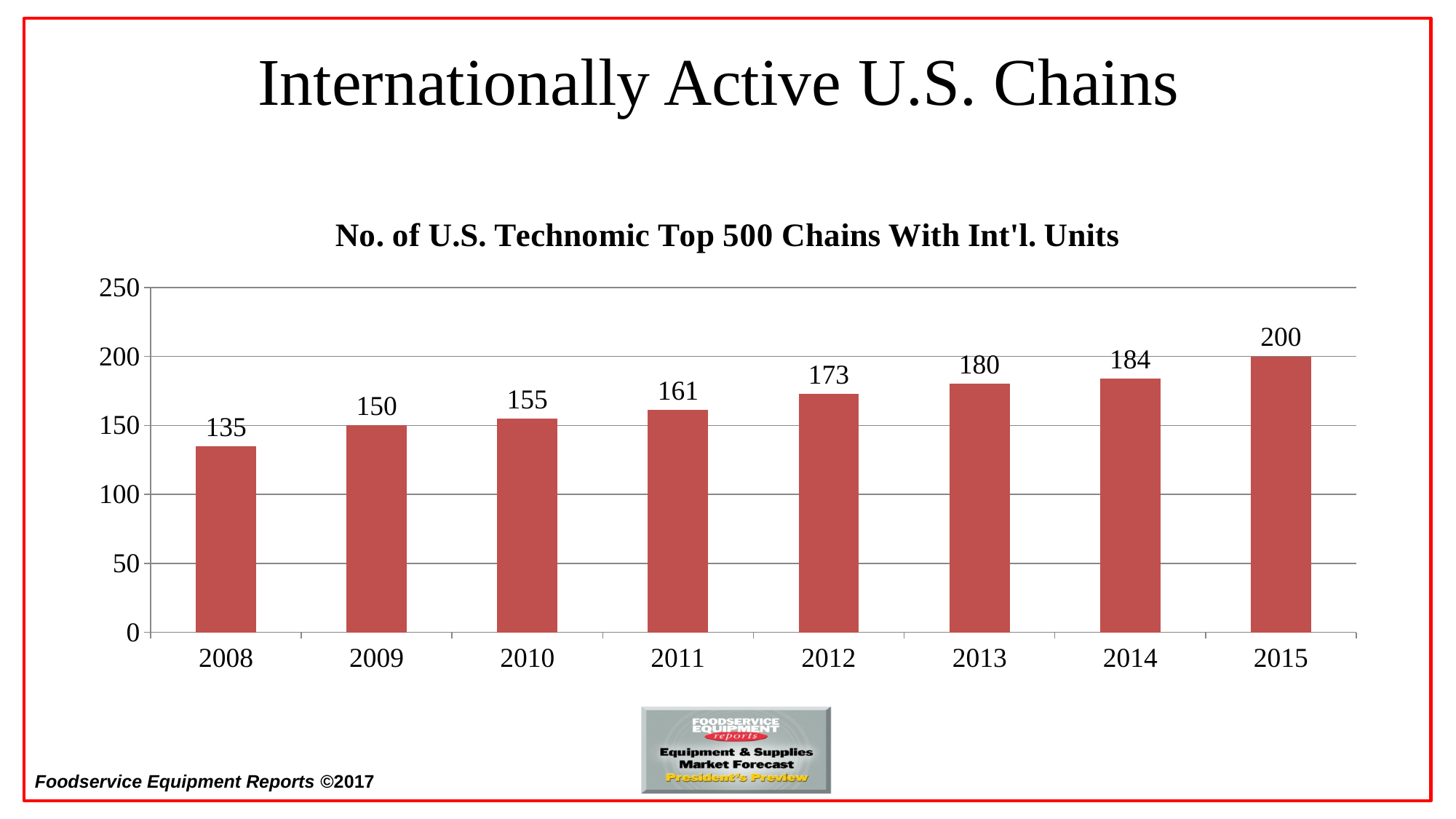
What is the difference between the values for 2015 and 2008? 65 How many years are shown on the x axis? 8 What is the value shown for 2015? 200 What is the difference between the values for 2014 and 2013? 4 Which year has the lowest number of chains with international units? 2008 Which is larger, the value for 2010 or the value for 2011? 2011 What kind of chart is shown on the slide? Bar chart Do the values rise or fall from 2008 to 2015? Rise What is the number of U.S. Technomic Top 500 chains with international units in 2008? 135 Is the value for 2009 greater or less than 100? greater Which year has the highest number of chains with international units? 2015 What is the value shown for 2012? 173